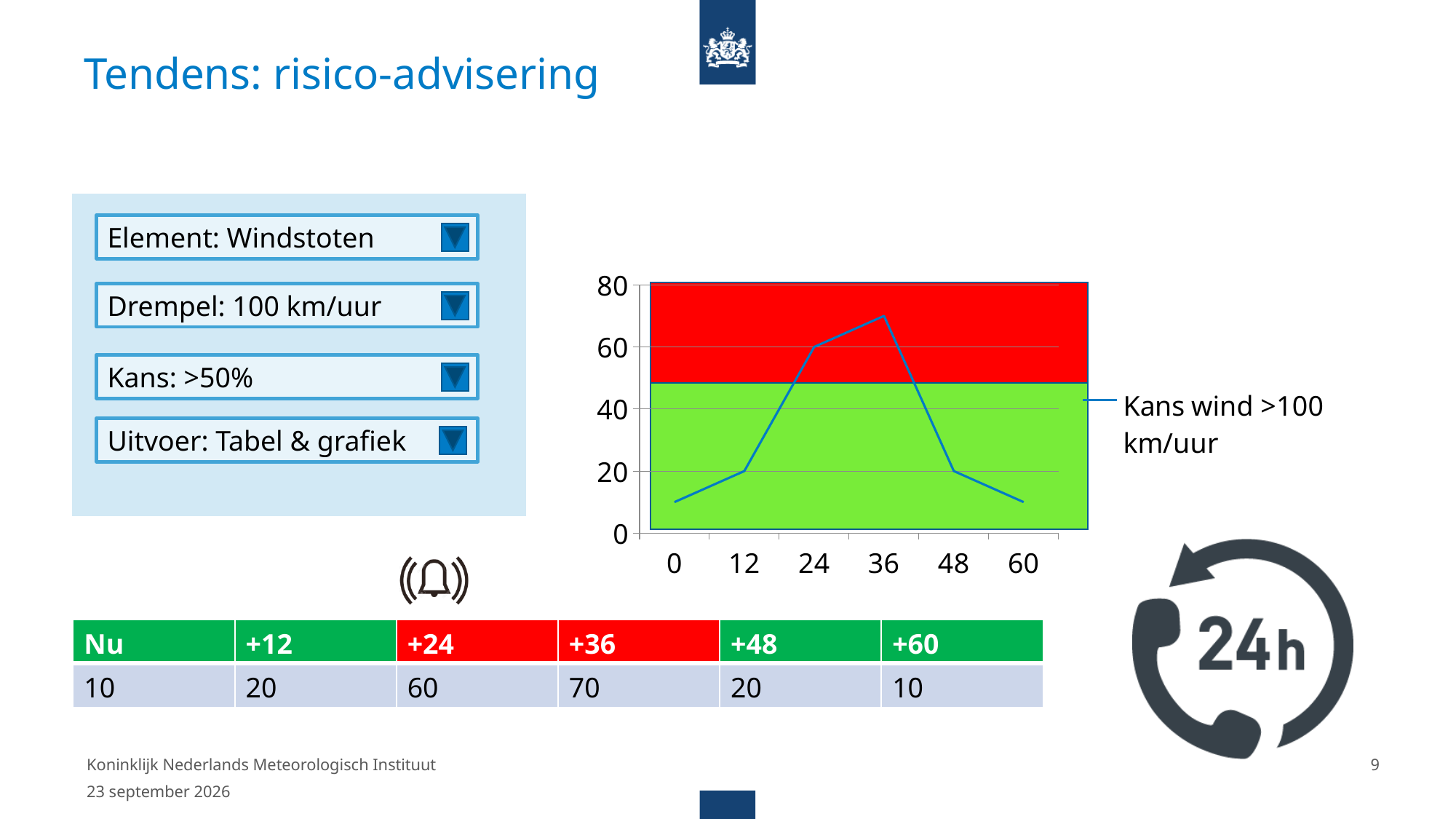
How many series does the legend list? 1 What kind of chart is shown on the slide? line chart What is the value of the line at x = 36? 70 Which is larger, the value at x = 12 or the value at x = 24? x = 24 What is the legend entry for the plotted line? Kans wind >100 km/uur At which x value does the line reach its highest point? 36 Is the value at x = 48 greater or less than 40? less What is the value of the line at x = 0? 10 How many data points are plotted on the line? 6 What is the difference between the values at x = 36 and x = 24? 10 Does the line rise or fall between x = 36 and x = 60? fall What is the value of the line at x = 24? 60